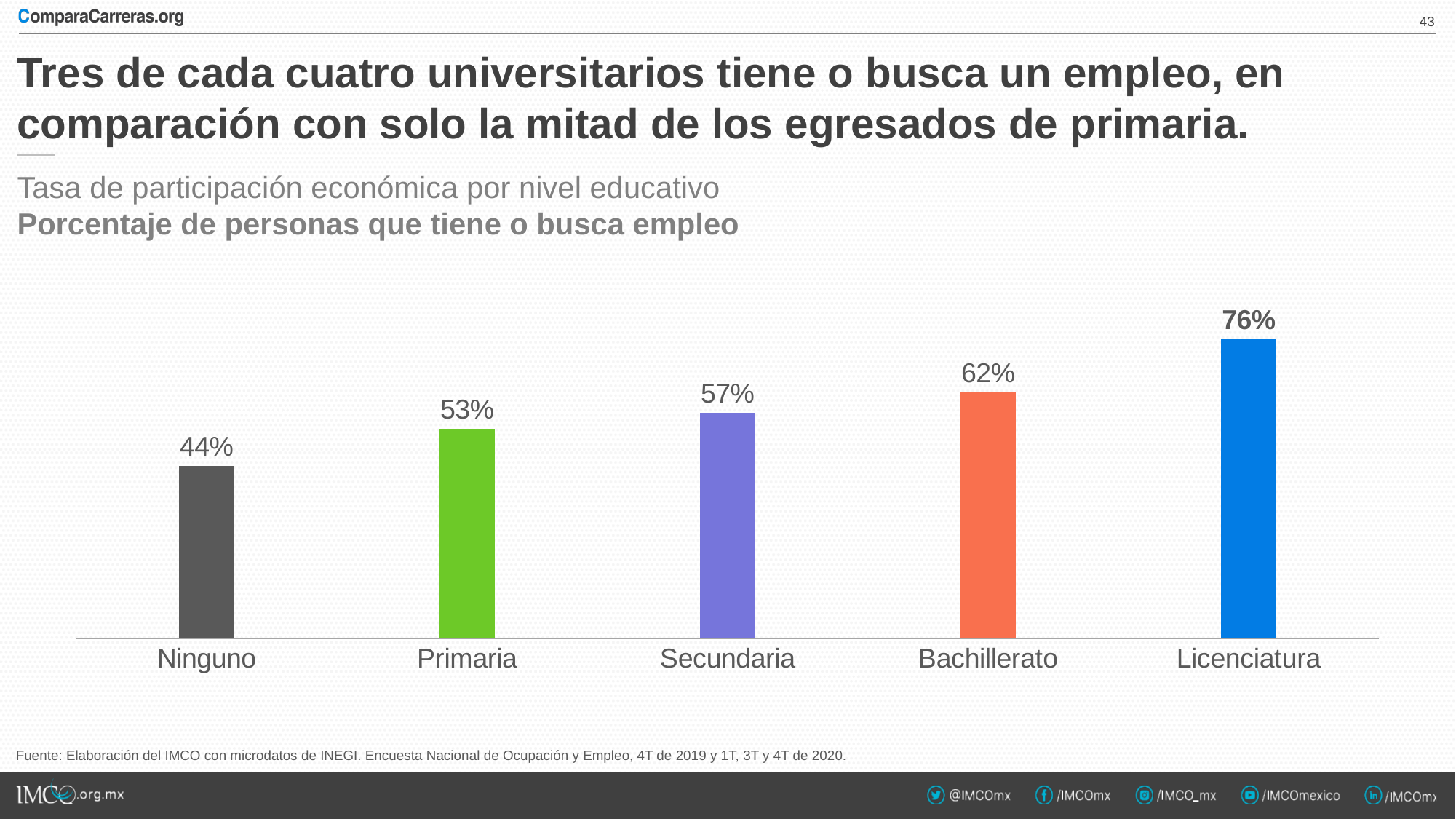
Which is larger, the value for Primaria or the value for Secundaria? Secundaria How many education levels are shown in the chart? 5 What is the difference between the values for Licenciatura and Primaria? 23% What is the difference between the values for Bachillerato and Secundaria? 5% Do the values rise or fall from Ninguno to Licenciatura? Rise What is the value for Licenciatura? 76% What is the value for Bachillerato? 62% Which education level has the highest participation rate? Licenciatura What is the value for Ninguno? 44% Which education level has the lowest participation rate? Ninguno What kind of chart is shown on the slide? Bar chart What is the value for Secundaria? 57%